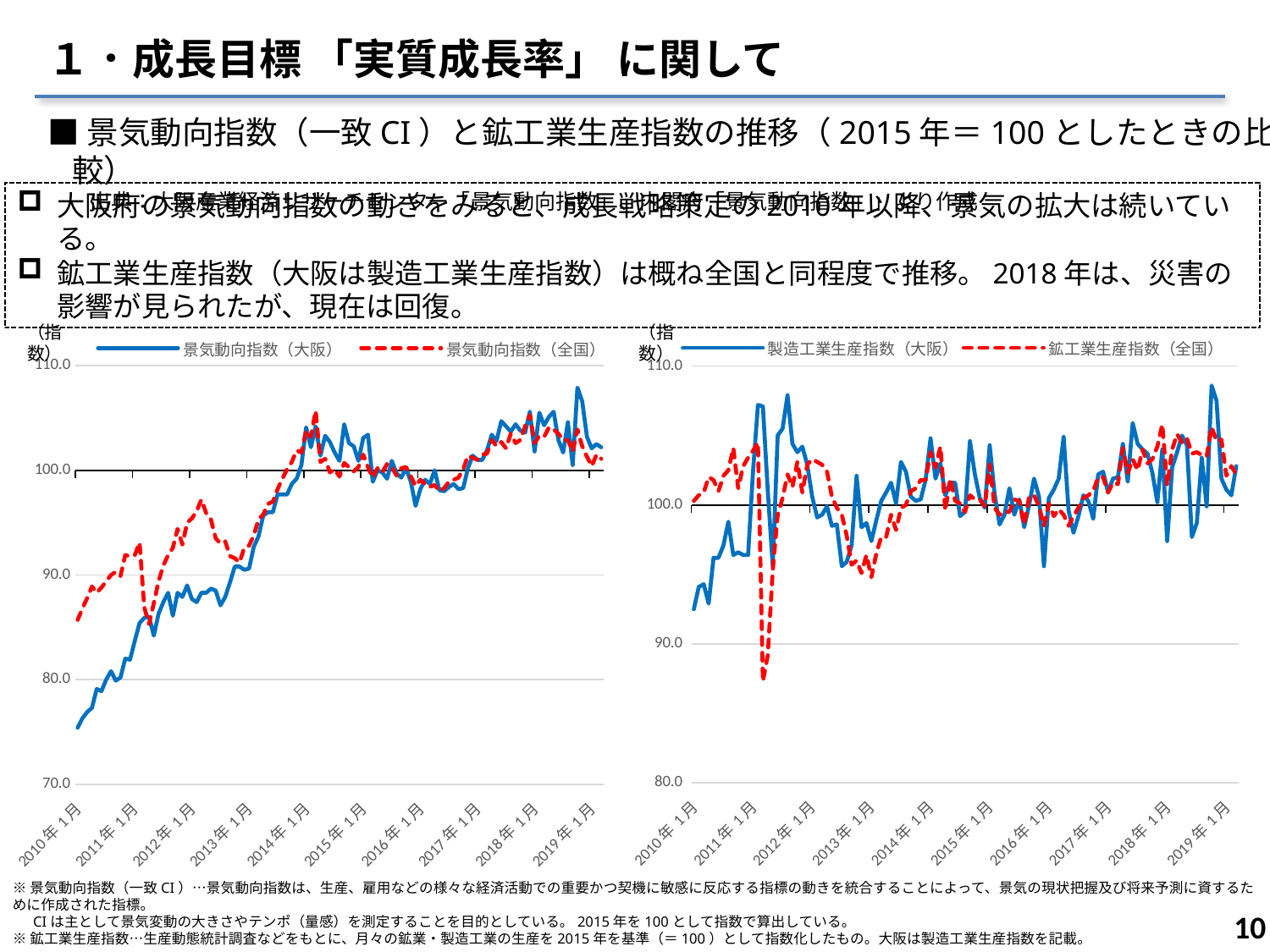
In the left chart, does 景気動向指数（大阪） generally rise or fall from 2010年1月 to 2019年1月? rise In the left chart, is the value of 景気動向指数（大阪） at 2019年1月 greater or less than 100.0? greater In the right chart, is the lowest point of 鉱工業生産指数（全国） in 2011 greater or less than 90.0? less What kind of chart is the right chart (鉱工業生産指数)? line chart How many series does the legend of the right chart list? 2 How many year labels (2010年1月 through 2019年1月) are shown on the x axis of the left chart? 10 How many series does the legend of the left chart list? 2 In the right chart, is the value of 製造工業生産指数（大阪） at 2010年1月 greater or less than 100.0? less What kind of chart is the left chart (景気動向指数)? line chart In the left chart, which series is drawn as a red dashed line? 景気動向指数（全国） In the right chart, which series is drawn as a solid blue line? 製造工業生産指数（大阪）